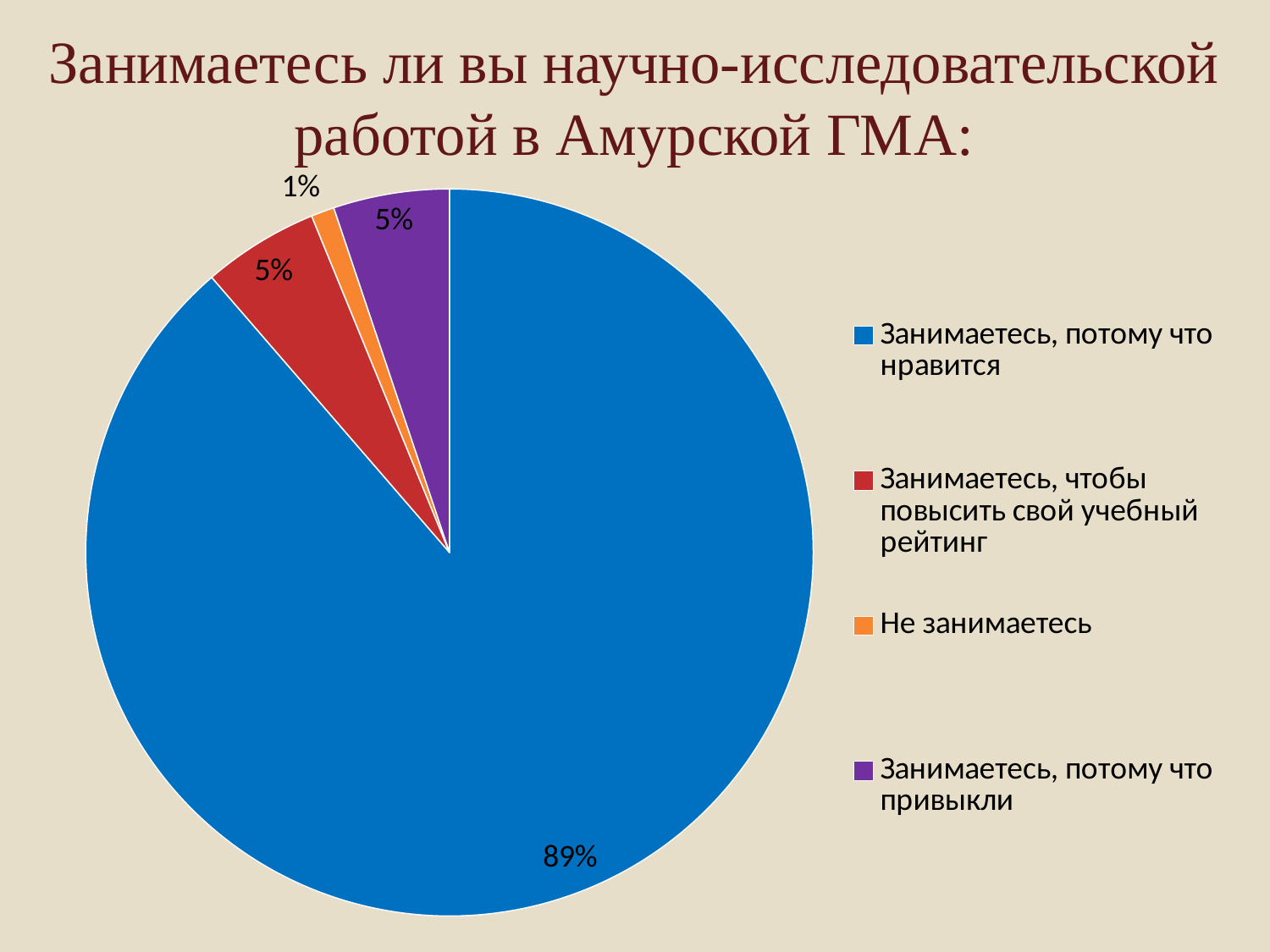
What colour is the slice for "Не занимаетесь"? Orange What share of respondents answered "Занимаетесь, потому что привыкли"? 5% What share of respondents answered "Занимаетесь, чтобы повысить свой учебный рейтинг"? 5% What kind of chart is shown on the slide? Pie chart Which answer has the smallest slice of the pie? Не занимаетесь By how many percentage points does "Занимаетесь, потому что нравится" exceed "Занимаетесь, потому что привыкли"? 84 percentage points What share of respondents answered "Занимаетесь, потому что нравится"? 89% Which is larger: the share for "Занимаетесь, чтобы повысить свой учебный рейтинг" or the share for "Не занимаетесь"? Занимаетесь, чтобы повысить свой учебный рейтинг What share of respondents answered "Не занимаетесь"? 1% How many slices does the pie chart have? 4 How many entries does the legend list? 4 Which answer has the largest slice of the pie? Занимаетесь, потому что нравится